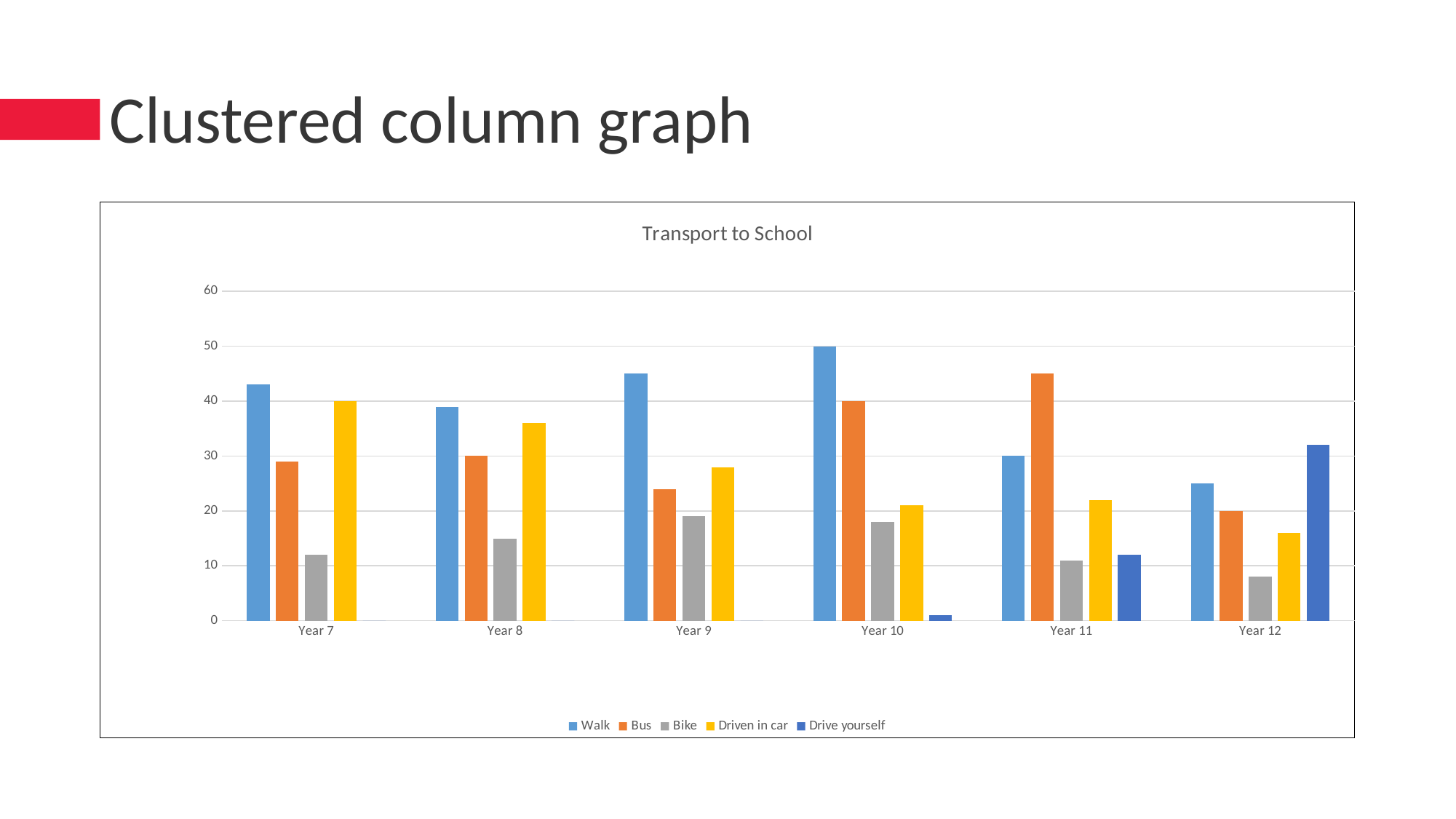
Does the Drive yourself value rise or fall from Year 10 to Year 12? rise What kind of chart is shown on the slide? bar chart In which year group is the Walk value highest? Year 10 How many year groups are shown on the x axis? 6 What is the value for Bus in Year 8? 30 What is the title of the chart? Transport to School Which is larger in Year 11, Walk or Bus? Bus What is the value for Driven in car in Year 7? 40 How many series does the legend list? 5 What is the value for Walk in Year 10? 50